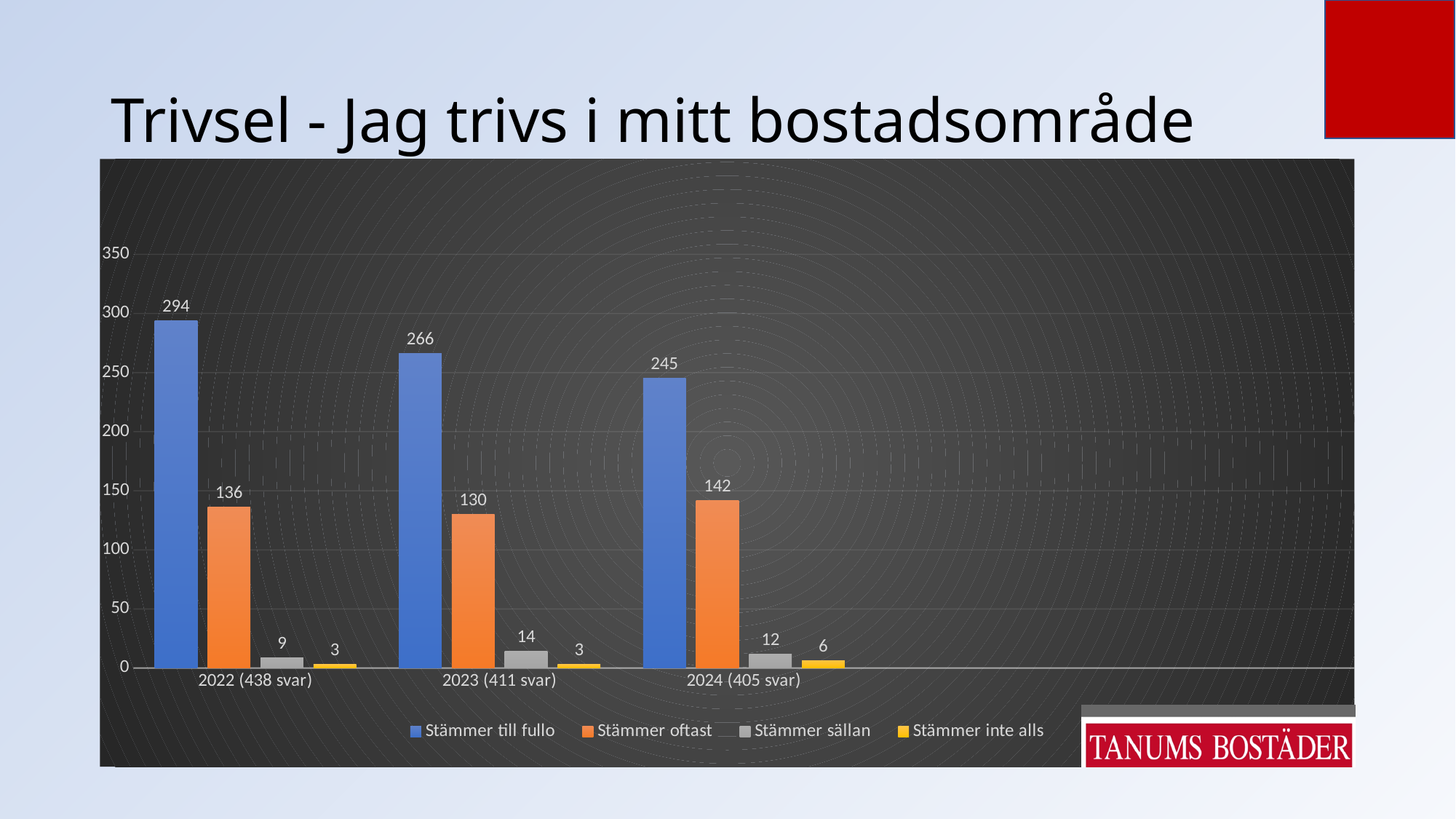
What is the value for "Stämmer sällan" in 2023 (411 svar)? 14 What is the difference between "Stämmer till fullo" in 2022 (438 svar) and in 2024 (405 svar)? 49 How many year categories are shown on the x axis? 3 In which year is the value for "Stämmer sällan" lowest? 2022 (438 svar) What is the value for "Stämmer inte alls" in 2024 (405 svar)? 6 What is the value for "Stämmer oftast" in 2024 (405 svar)? 142 What is the value for "Stämmer till fullo" in 2022 (438 svar)? 294 What kind of chart is shown on the slide? Bar chart How many series does the legend list? 4 In which year is the value for "Stämmer till fullo" highest? 2022 (438 svar) Which is larger: "Stämmer oftast" in 2022 (438 svar) or in 2023 (411 svar)? 2022 (438 svar) Does the value for "Stämmer till fullo" rise or fall from 2022 to 2024? Fall